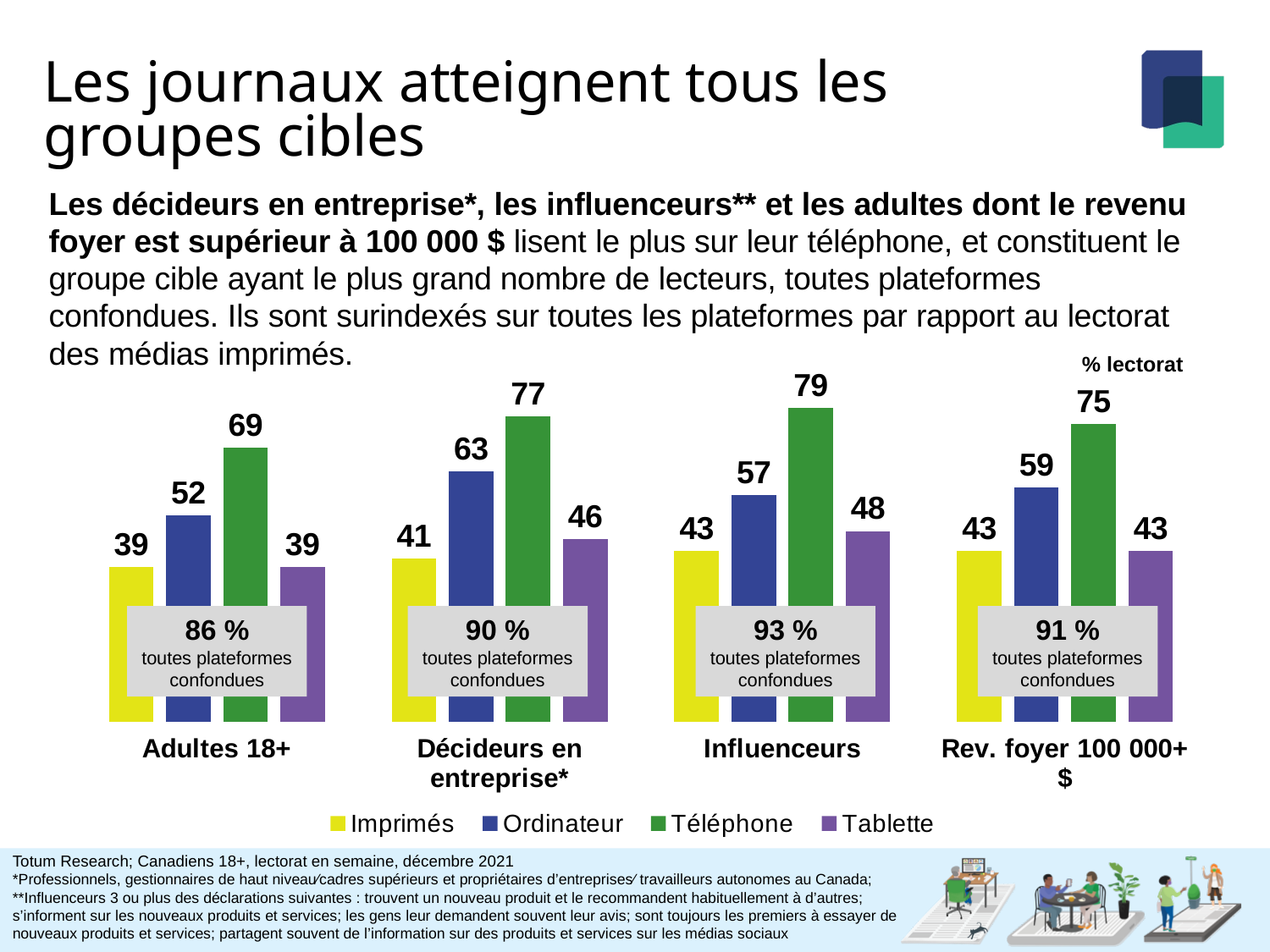
How many categories are shown on the x axis? 4 What is the Ordinateur value for Adultes 18+? 52 How many series does the legend list? 4 What is the Tablette value for Décideurs en entreprise*? 46 What is the Imprimés value for Rev. foyer 100 000+ $? 43 What is the Téléphone value for Influenceurs? 79 What 'toutes plateformes confondues' percentage is shown for Influenceurs? 93 % Which category has the lowest Ordinateur value? Adultes 18+ What kind of chart is shown on the slide? Bar chart What is the difference between the Téléphone and Imprimés values for Décideurs en entreprise*? 36 Which is larger for Rev. foyer 100 000+ $: the Ordinateur value or the Tablette value? Ordinateur Which category has the highest Téléphone value? Influenceurs